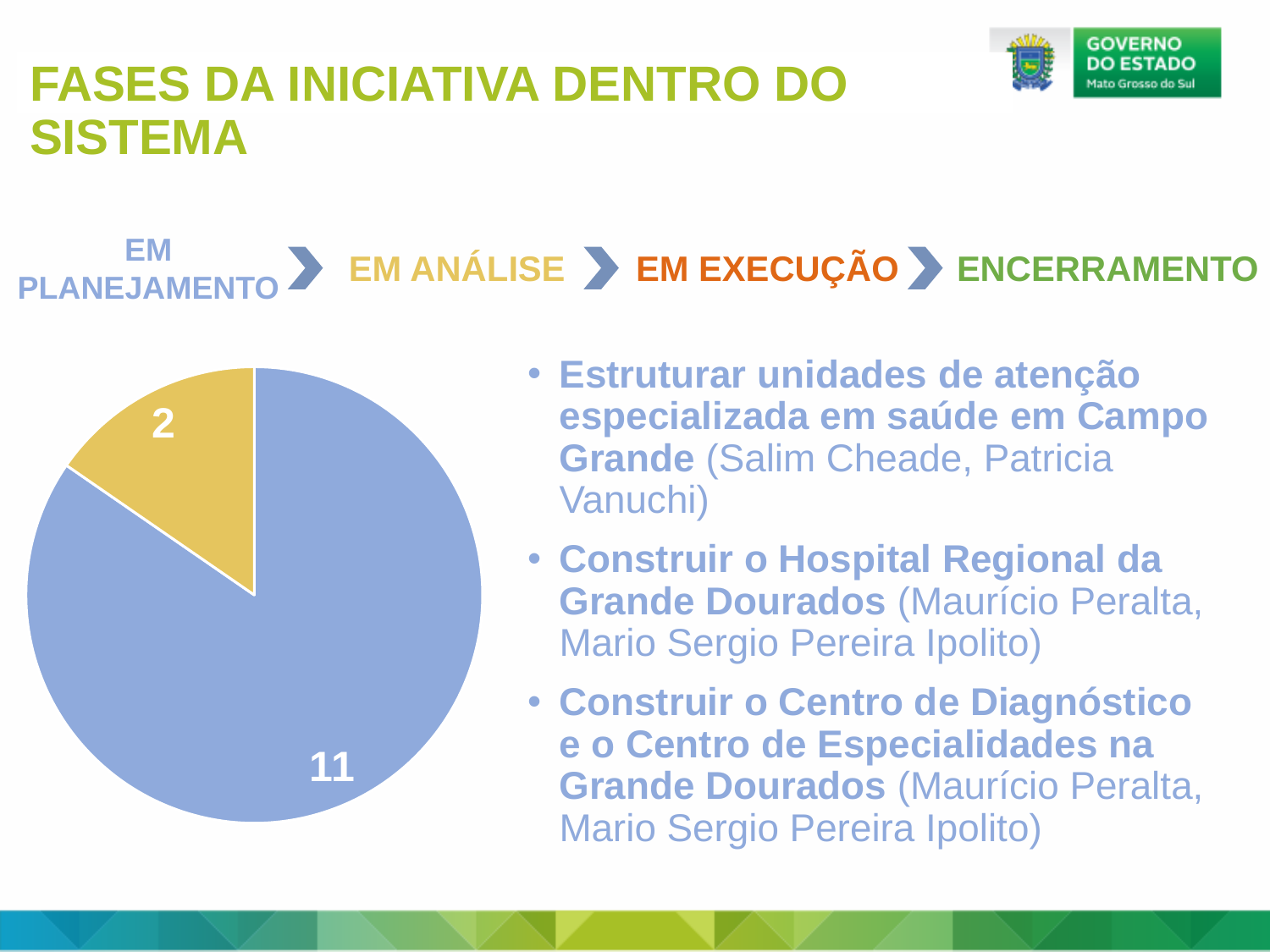
What is the difference between the values of the blue slice and the yellow slice? 9 What is the smallest value shown in the pie chart? 2 What colour is the slice labelled 2 in the pie chart? yellow What is the largest value shown in the pie chart? 11 What kind of chart is shown on the slide? pie chart Does the pie chart have a legend? No What value is printed on the yellow slice of the pie chart? 2 Which slice of the pie chart is larger, the blue one or the yellow one? the blue one How many slices does the pie chart have? 2 What value is printed on the blue slice of the pie chart? 11 What is the total of the values shown in the pie chart? 13